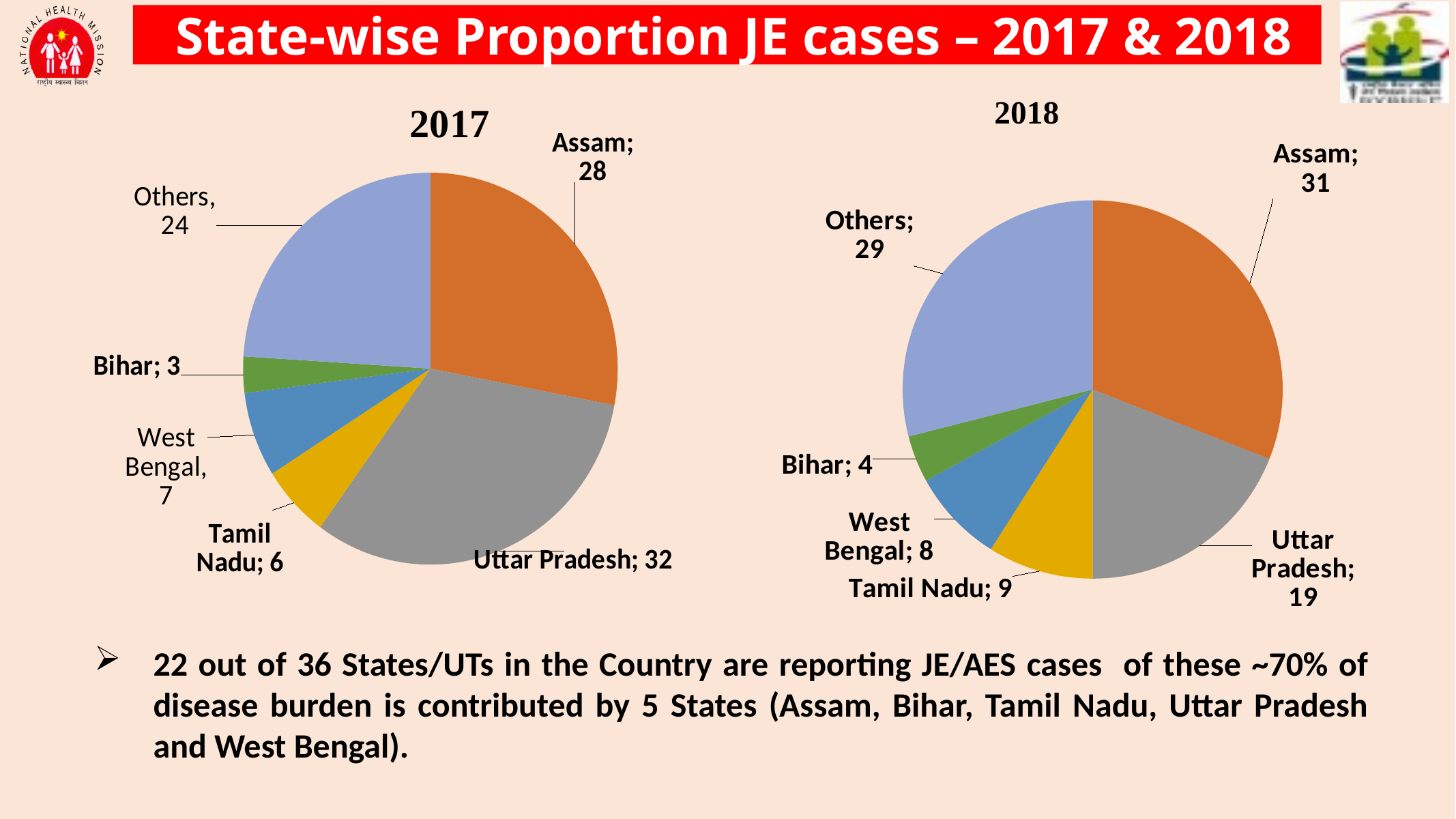
In the 2017 pie chart, which is larger, the value for West Bengal or the value for Tamil Nadu? West Bengal What is the title of the slide containing the two pie charts? State-wise Proportion JE cases – 2017 & 2018 What type of chart is used to show the 2017 data? Pie chart In the 2017 pie chart, what is the value for Uttar Pradesh? 32 In the 2018 pie chart, which state has the smallest slice? Bihar How many slices does the 2018 pie chart have? 6 In the 2017 pie chart, what is the difference between the values for Uttar Pradesh and Others? 8 In the 2018 pie chart, what is the difference between the values for Assam and Uttar Pradesh? 12 In the 2017 pie chart, what share of the pie does Assam represent? 28% In the 2018 pie chart, what is the value for Tamil Nadu? 9 In the 2017 pie chart, which state has the largest slice? Uttar Pradesh In the 2018 pie chart, what is the value for Assam? 31